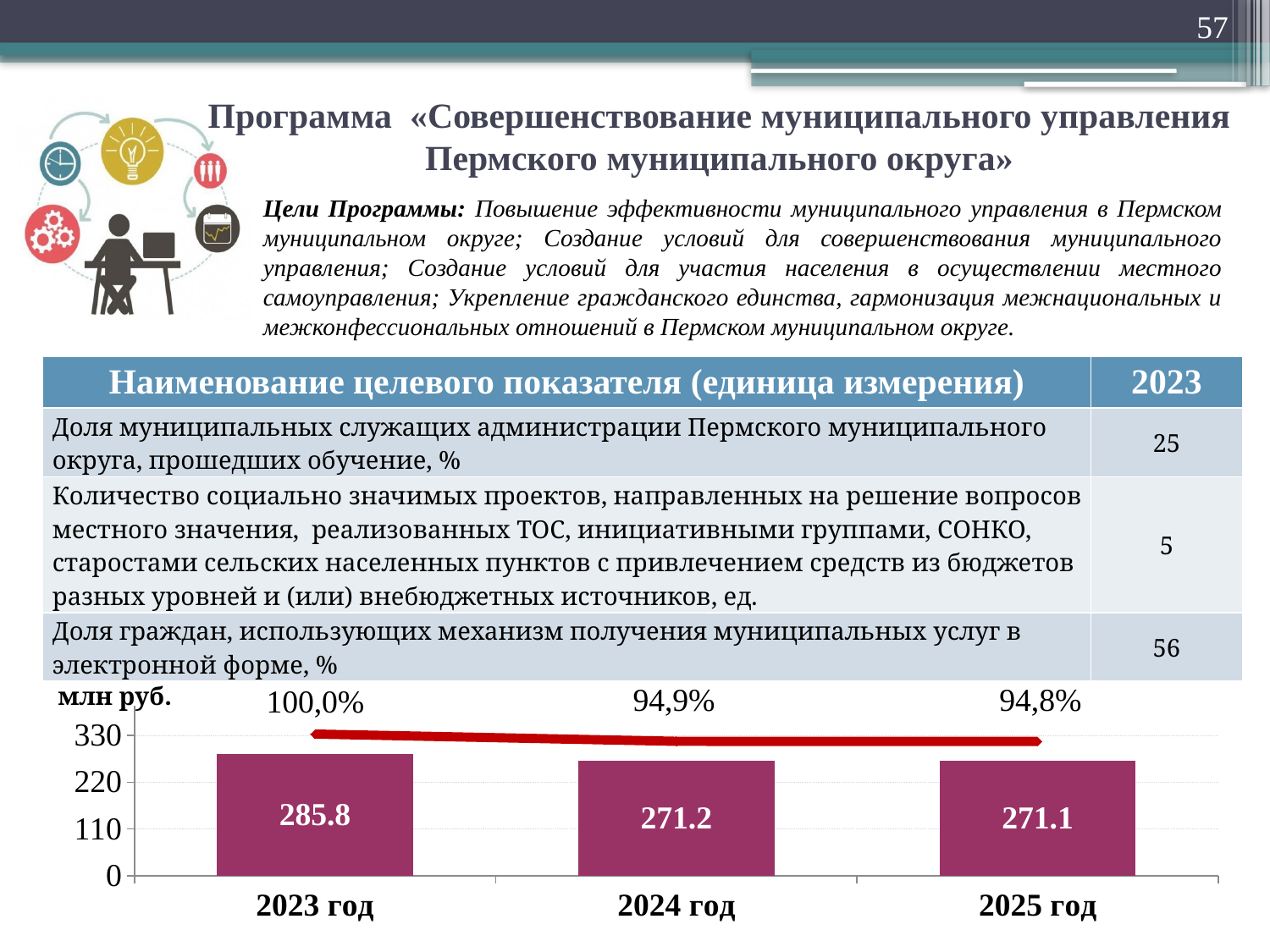
What is the value for 2023 год in the bar chart? 285.8 Is the value for 2023 год greater or less than 220? greater What is the value for 2024 год in the bar chart? 271.2 What is the value for 2025 год in the bar chart? 271.1 What is the difference between the values for 2023 год and 2024 год? 14.6 Do the values rise or fall from 2023 год to 2025 год? fall Which year has the lowest value in the bar chart? 2025 год What kind of chart is shown at the bottom of the slide? combination bar and line chart Which year has the highest value in the bar chart? 2023 год Which is larger, the value for 2023 год or the value for 2024 год? 2023 год What is the difference between the values for 2023 год and 2025 год? 14.7 How many bars are shown in the bar chart? 3